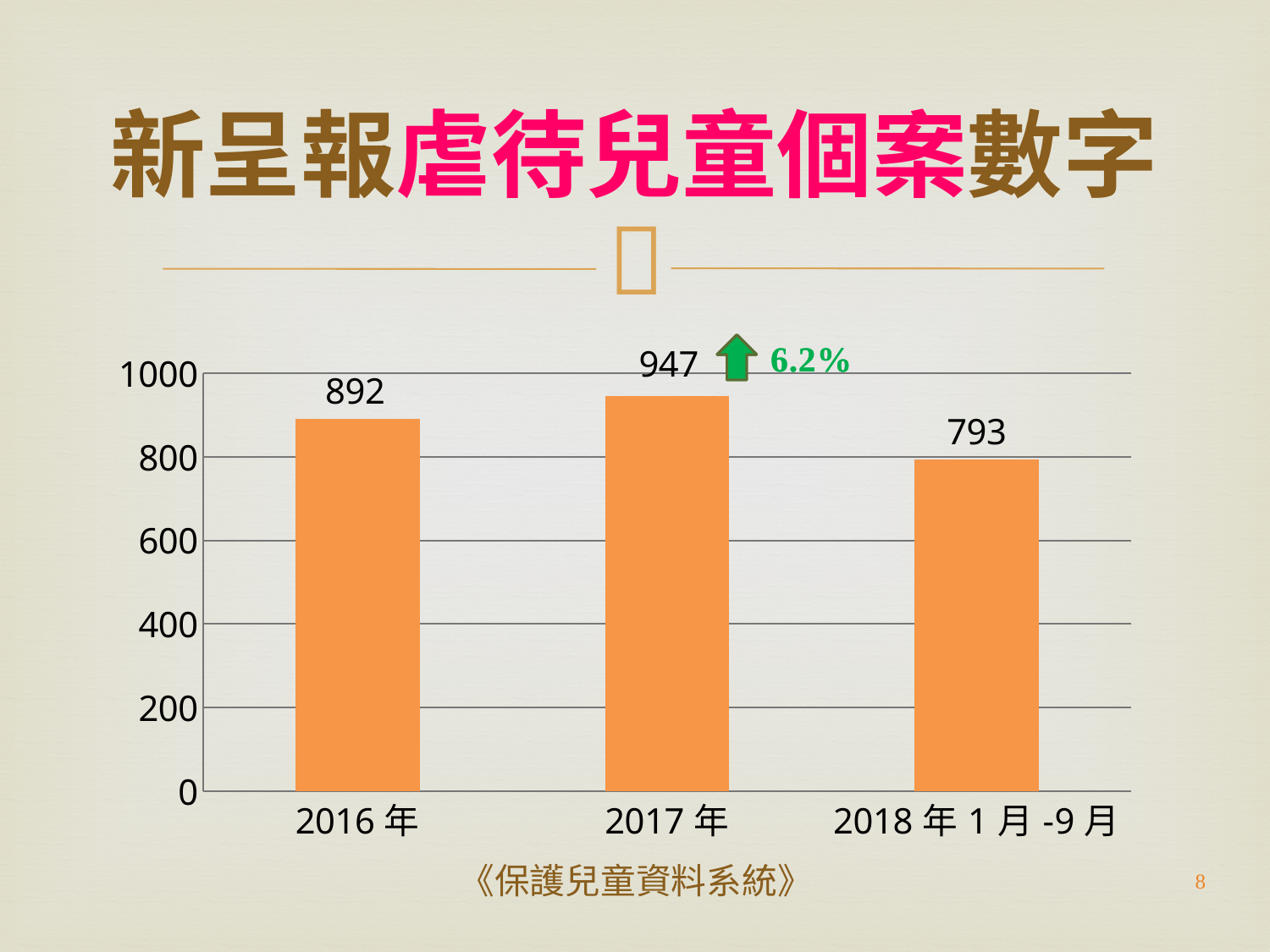
What is the difference between the values for 2017 年 and 2016 年? 55 Which category has the highest value? 2017 年 What is the value for 2018 年 1 月 -9 月? 793 Which is larger, the value for 2016 年 or the value for 2018 年 1 月 -9 月? 2016 年 How many categories are shown on the x axis? 3 What is the value for 2016 年? 892 Is the value for 2018 年 1 月 -9 月 greater or less than 800? less What percentage increase is annotated next to the 2017 年 bar? 6.2% What kind of chart is shown on the slide? bar chart What is the difference between the values for 2017 年 and 2018 年 1 月 -9 月? 154 Which category has the lowest value? 2018 年 1 月 -9 月 What is the value for 2017 年? 947